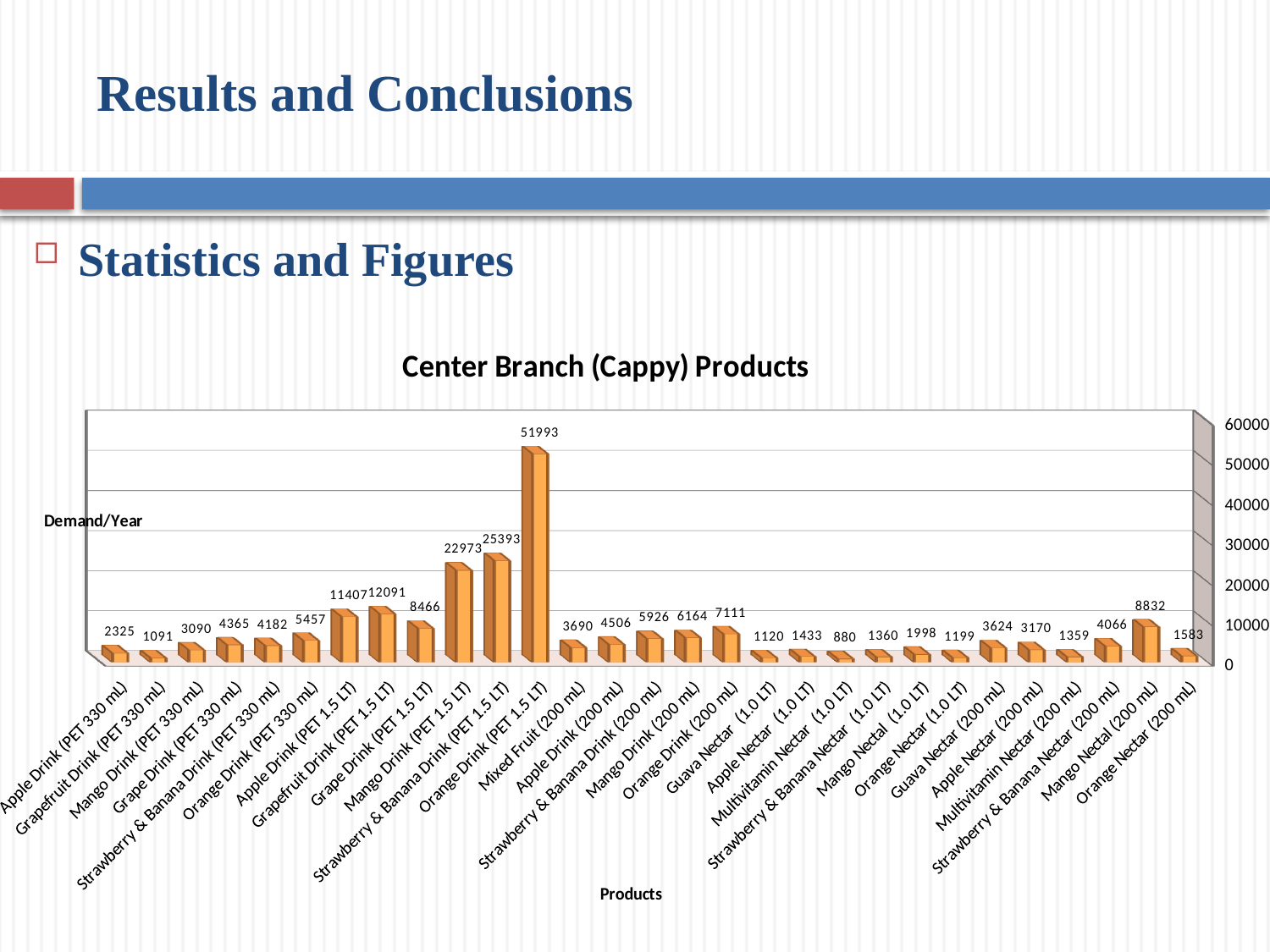
Which product has the lowest Demand/Year? Multivitamin Nectar (1.0 LT) What is the difference in Demand/Year between Grapefruit Drink (PET 1.5 LT) and Apple Drink (PET 1.5 LT)? 684 What is the difference in Demand/Year between Orange Drink (PET 1.5 LT) and Strawberry & Banana Drink (PET 1.5 LT)? 26600 Is the Demand/Year value for Orange Drink (PET 1.5 LT) greater or less than 50000? greater How many products are shown on the x axis of the chart? 29 What is the Demand/Year value for Orange Drink (PET 1.5 LT)? 51993 Which has a larger Demand/Year: Mango Drink (PET 1.5 LT) or Strawberry & Banana Drink (PET 1.5 LT)? Strawberry & Banana Drink (PET 1.5 LT) What is the title of the chart? Center Branch (Cappy) Products What is the Demand/Year value for Grapefruit Drink (PET 330 mL)? 1091 What kind of chart is shown on the slide? bar chart What is the Demand/Year value for Mango Nectal (200 mL)? 8832 Which product has the highest Demand/Year? Orange Drink (PET 1.5 LT)